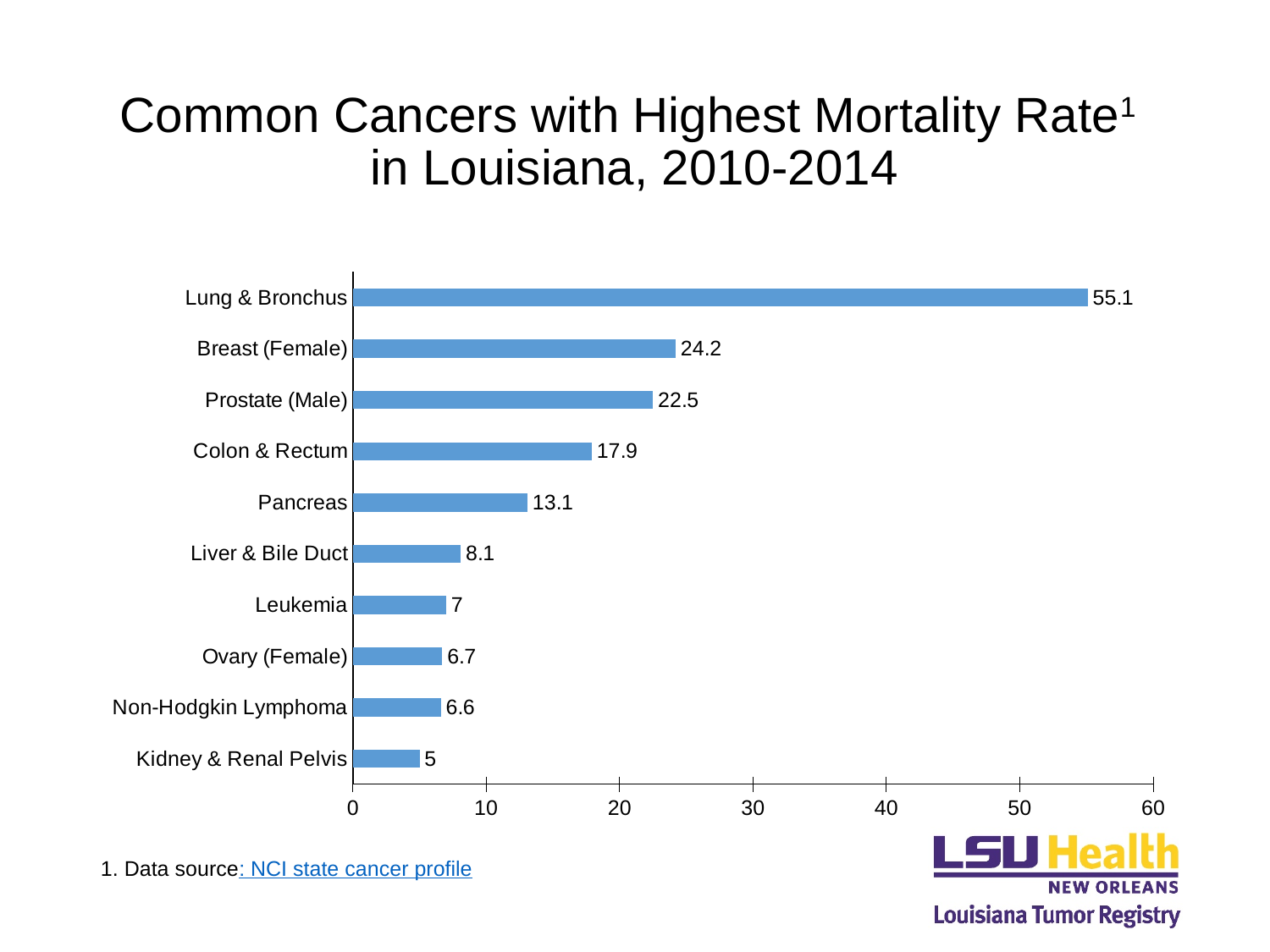
What is the mortality rate for Lung & Bronchus cancer? 55.1 What is the maximum value shown on the horizontal axis? 60 What is the difference between the values for Lung & Bronchus and Colon & Rectum? 37.2 What is the difference between the values for Breast (Female) and Prostate (Male)? 1.7 Which has a higher value, Liver & Bile Duct or Leukemia? Liver & Bile Duct Which cancer has the lowest mortality rate on the chart? Kidney & Renal Pelvis What is the value shown for Non-Hodgkin Lymphoma? 6.6 What kind of chart is shown on the slide? Bar chart Which cancer has the highest mortality rate on the chart? Lung & Bronchus Is the value for Colon & Rectum greater or less than 20? less What is the value shown for Pancreas? 13.1 How many cancer types are shown on the chart? 10